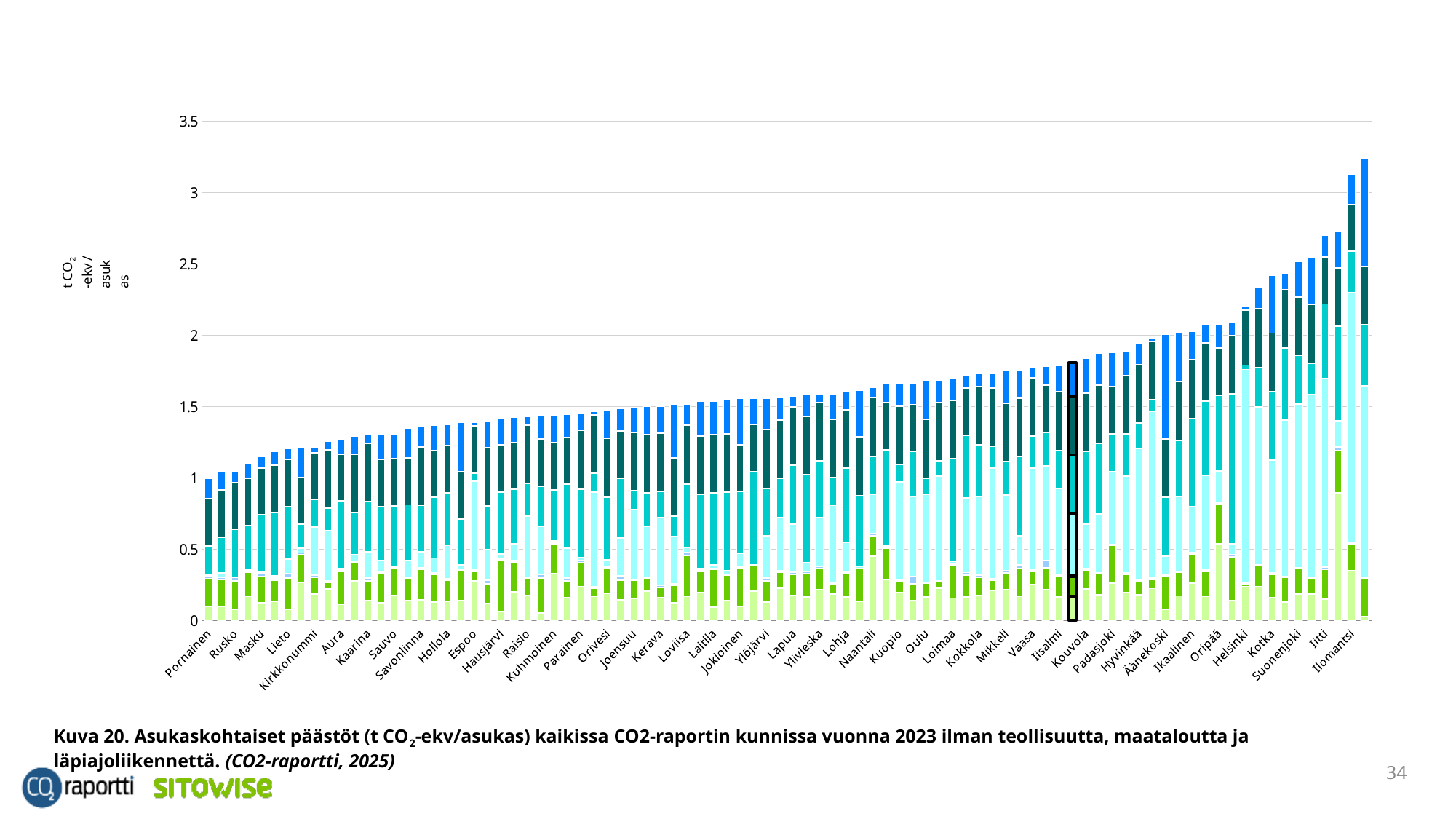
Which municipality's bar is outlined with a black box in the chart? Kouvola Which municipality has the lowest total emissions per inhabitant in the chart? Pornainen Is the total value for Pornainen greater or less than 1.5? less Do the bar totals rise or fall from left to right along the x axis? rise Is the total value for Ilomantsi greater or less than 3? greater Is the total value for Kouvola greater or less than 1.5? greater What unit is shown on the y axis of the chart? t CO2-ekv / asukas Which has the larger total value, Helsinki or Pornainen? Helsinki What kind of chart is shown on the slide? stacked bar chart